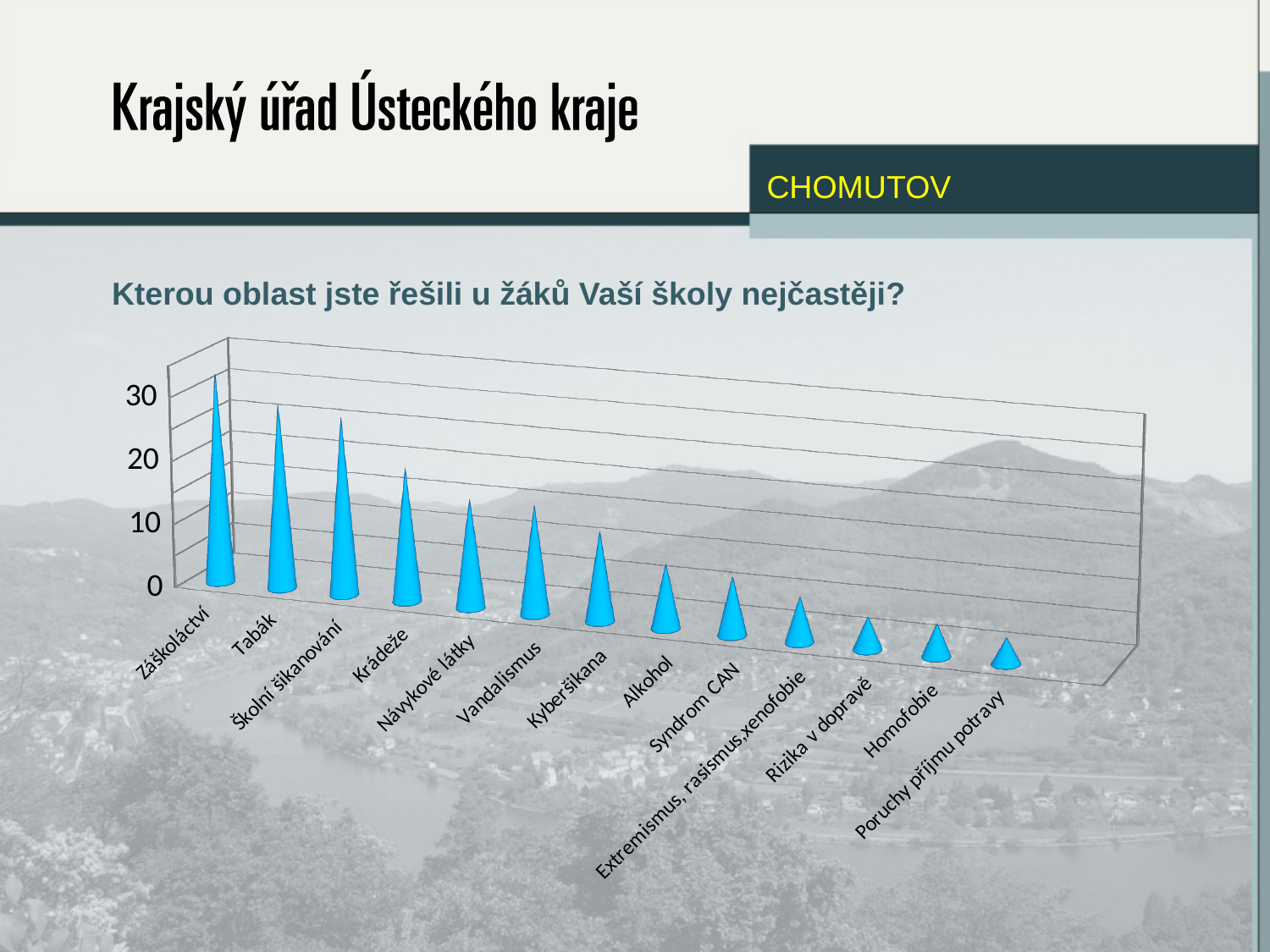
Which category has the highest value in the chart? Záškoláctví Which is larger, the value for Tabák or the value for Krádeže? Tabák What kind of chart is shown on the slide? bar chart Is the value for Záškoláctví greater or less than 20? greater Which category has the lowest value in the chart? Poruchy příjmu potravy How many categories are shown on the x axis of the chart? 13 Is the value for Poruchy příjmu potravy greater or less than 10? less Do the values rise or fall moving from left to right along the x axis? fall Is the value for Krádeže greater or less than 10? greater What question is the chart titled with? Kterou oblast jste řešili u žáků Vaší školy nejčastěji?